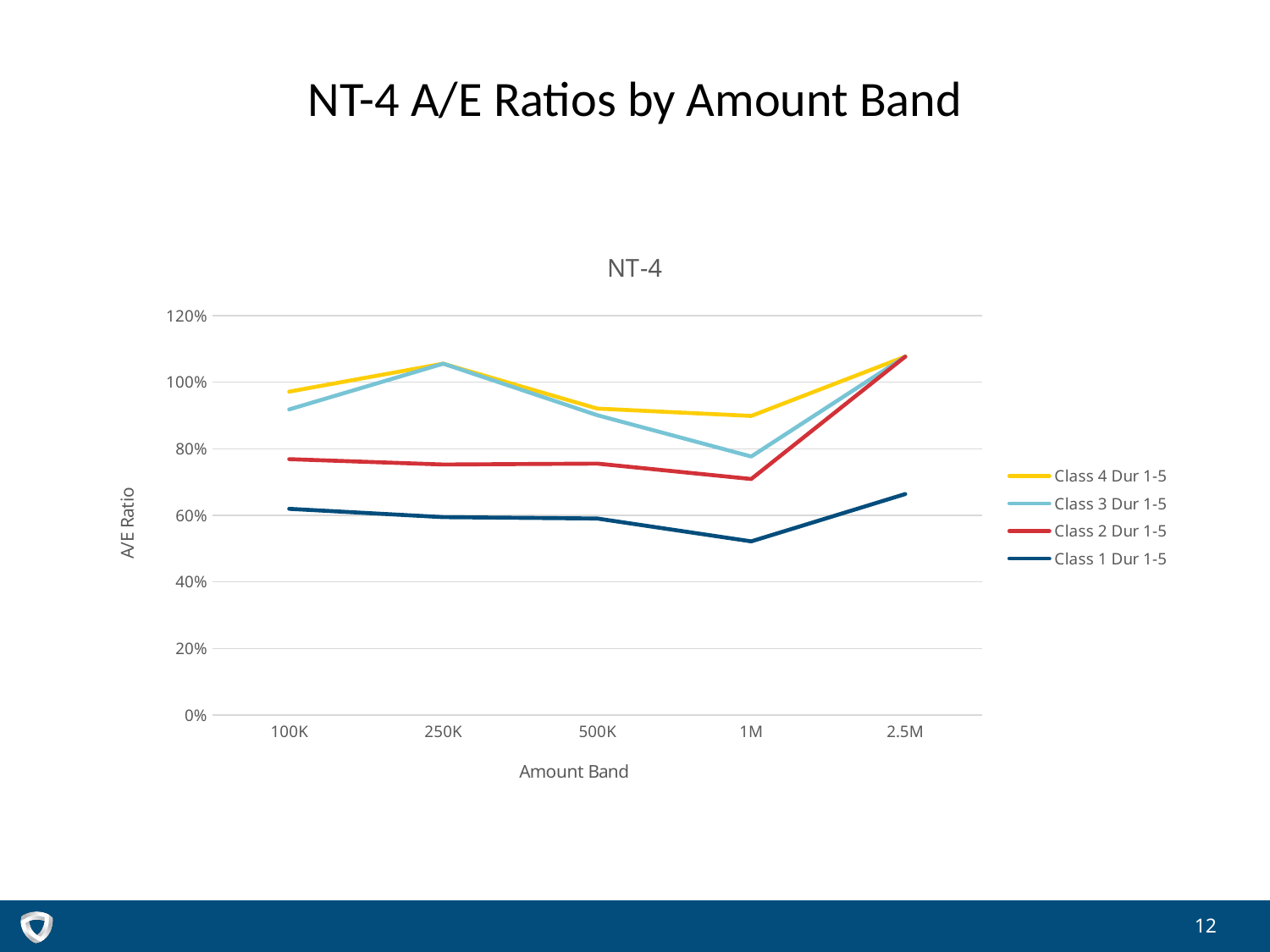
How many amount bands are plotted along the x axis? 5 Is the value for Class 1 Dur 1-5 at 2.5M greater or less than 60%? greater Is the value for Class 2 Dur 1-5 at 100K greater or less than 80%? less Which series has the lowest value at the 100K amount band? Class 1 Dur 1-5 Is the value for Class 1 Dur 1-5 at 1M greater or less than 60%? less What is the title of the x axis? Amount Band At the 1M amount band, which is larger: Class 4 Dur 1-5 or Class 3 Dur 1-5? Class 4 Dur 1-5 At which amount band is Class 2 Dur 1-5 at its highest? 2.5M At which amount band is Class 1 Dur 1-5 at its lowest? 1M How many series does the legend list? 4 What kind of chart is shown on the slide? line chart